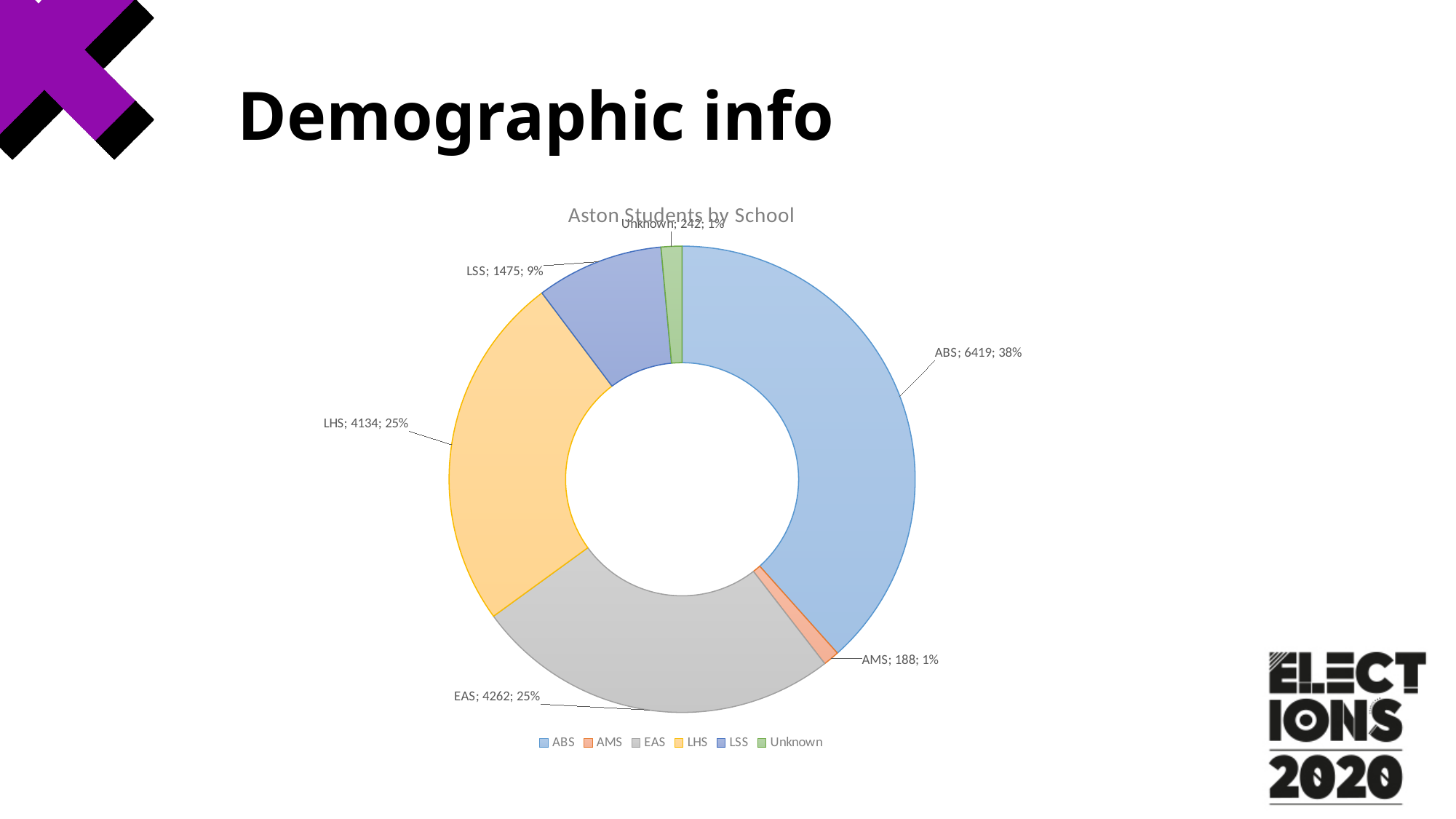
Which has more students, EAS or LHS? EAS What percentage share does ABS have in the chart? 38% What is the difference in student numbers between LSS and Unknown? 1233 How many schools (categories) does the chart show? 6 What kind of chart is shown on the slide? doughnut chart How many students are in the Unknown category? 242 Which school has the largest number of students? ABS What is the difference in student numbers between ABS and LHS? 2285 How many students are in ABS according to the chart? 6419 What is the title of the chart? Aston Students by School Which category has the smallest number of students? AMS What percentage share does LSS have in the chart? 9%